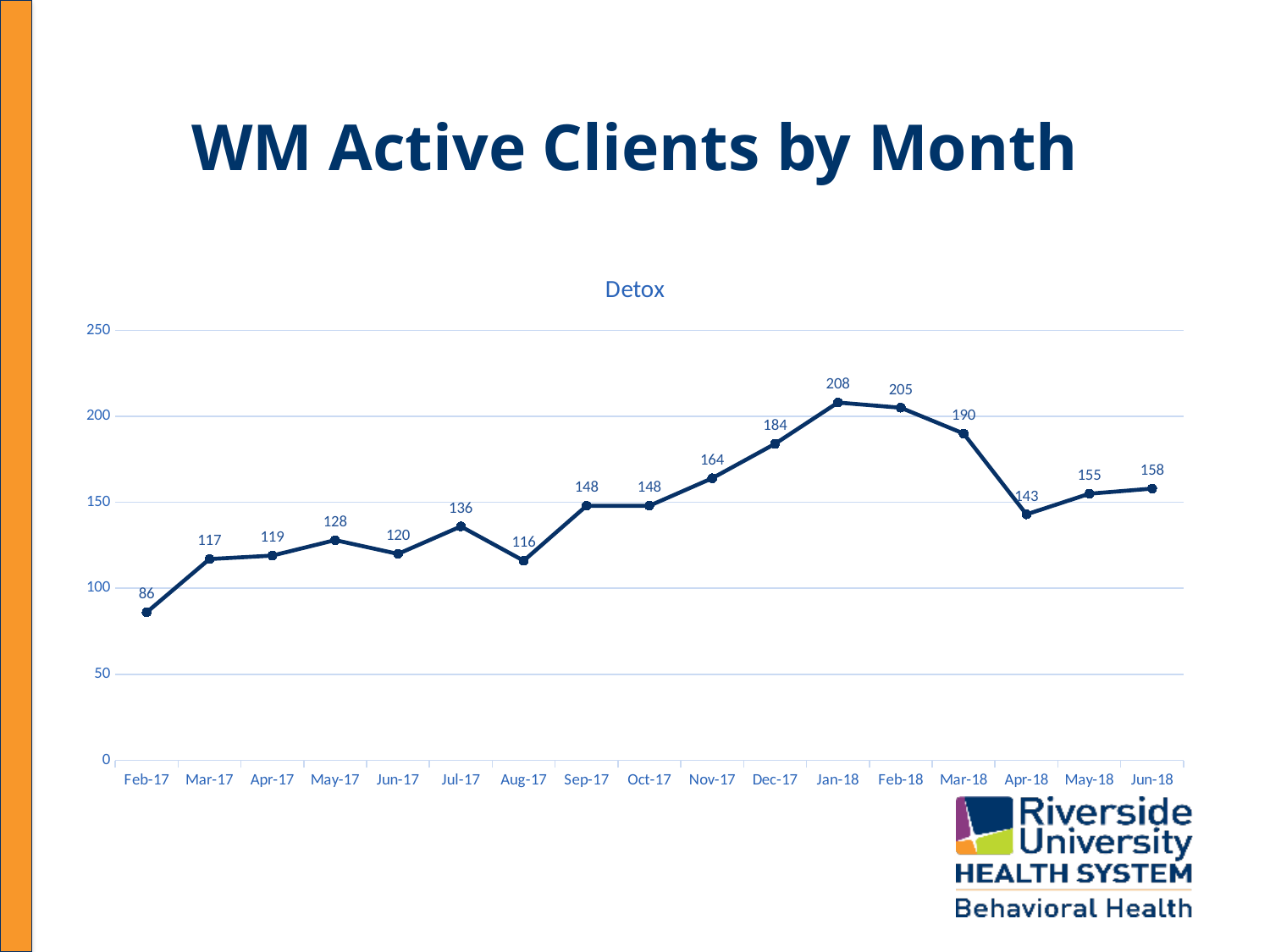
Is the value for Nov-17 greater or less than 150? greater What is the title of the chart? Detox Which month has the highest value? Jan-18 What is the value for Jan-18? 208 Do the values generally rise or fall from Feb-17 to Jan-18? rise What is the difference between the values for Jan-18 and Apr-18? 65 How many months are plotted on the chart? 17 What kind of chart is shown? line chart Which is larger, the value for Dec-17 or the value for Mar-18? Mar-18 What is the value for Feb-17? 86 What is the value for Aug-17? 116 Which month has the lowest value? Feb-17